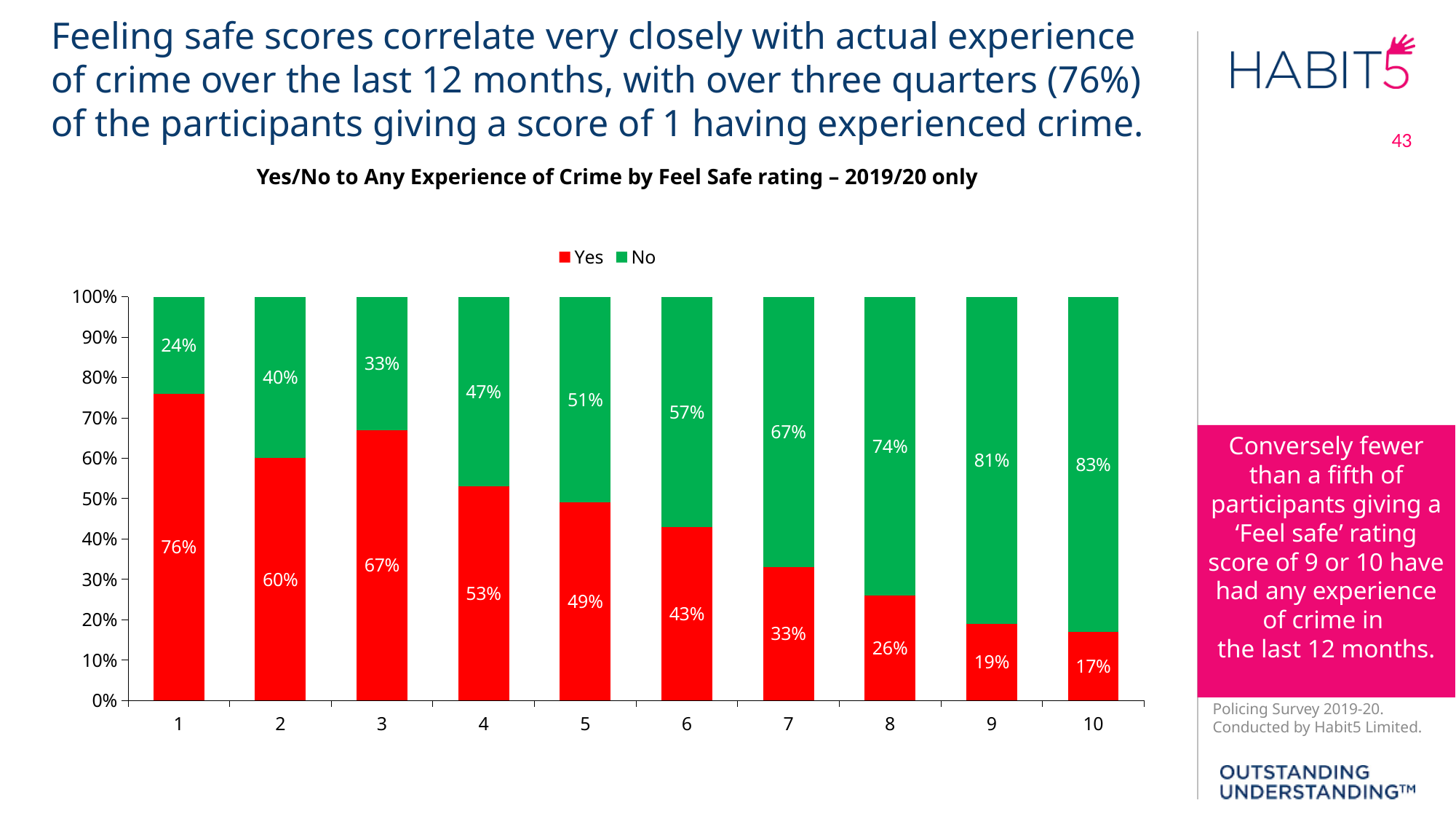
How many Feel Safe rating categories are shown on the x axis? 10 Do the 'No' values generally rise or fall as the Feel Safe rating increases from 1 to 10? rise Which colour represents the 'Yes' series? red What is the 'No' value for Feel Safe rating 10? 83% Which Feel Safe rating has the lowest 'Yes' value? 10 What is the 'Yes' value for Feel Safe rating 5? 49% Which is larger: the 'No' value for rating 4 or the 'No' value for rating 6? rating 6 What is the difference between the 'Yes' values for ratings 1 and 2? 16% Which Feel Safe rating has the highest 'Yes' value? 1 What is the 'Yes' value for Feel Safe rating 1? 76% How many series does the legend list? 2 What kind of chart is shown? stacked bar chart